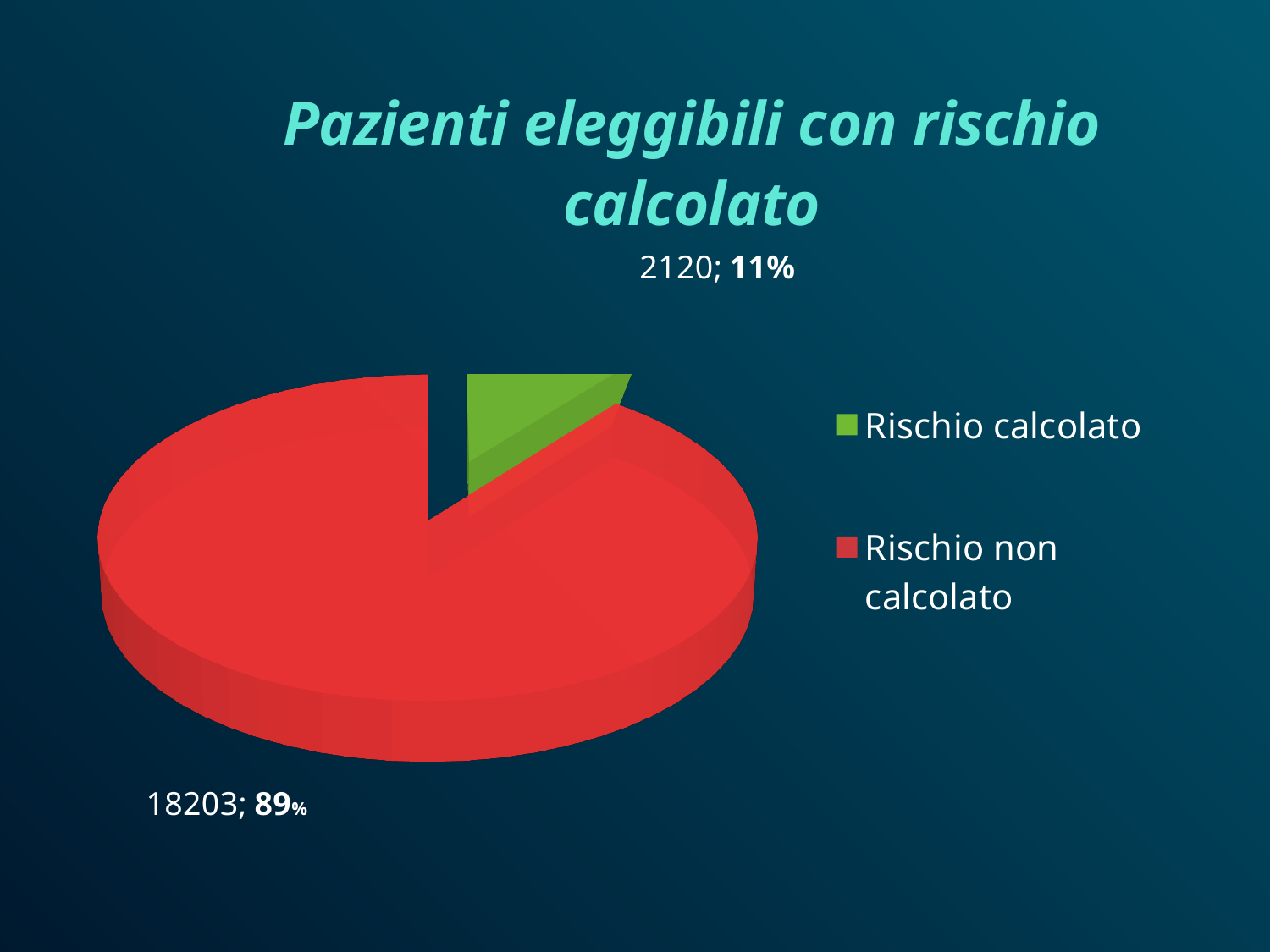
How many slices does the pie chart have? 2 What share of the pie does Rischio calcolato represent? 11% How many entries does the legend list? 2 Which colour represents Rischio calcolato in the chart? Green Which category has the smallest slice? Rischio calcolato Which category has the largest slice? Rischio non calcolato What share of the pie does Rischio non calcolato represent? 89% What kind of chart is shown on the slide? Pie chart What is the title of the chart? Pazienti eleggibili con rischio calcolato What is the difference between the values for Rischio non calcolato and Rischio calcolato? 16083 What is the value for Rischio non calcolato? 18203 What is the value for Rischio calcolato? 2120